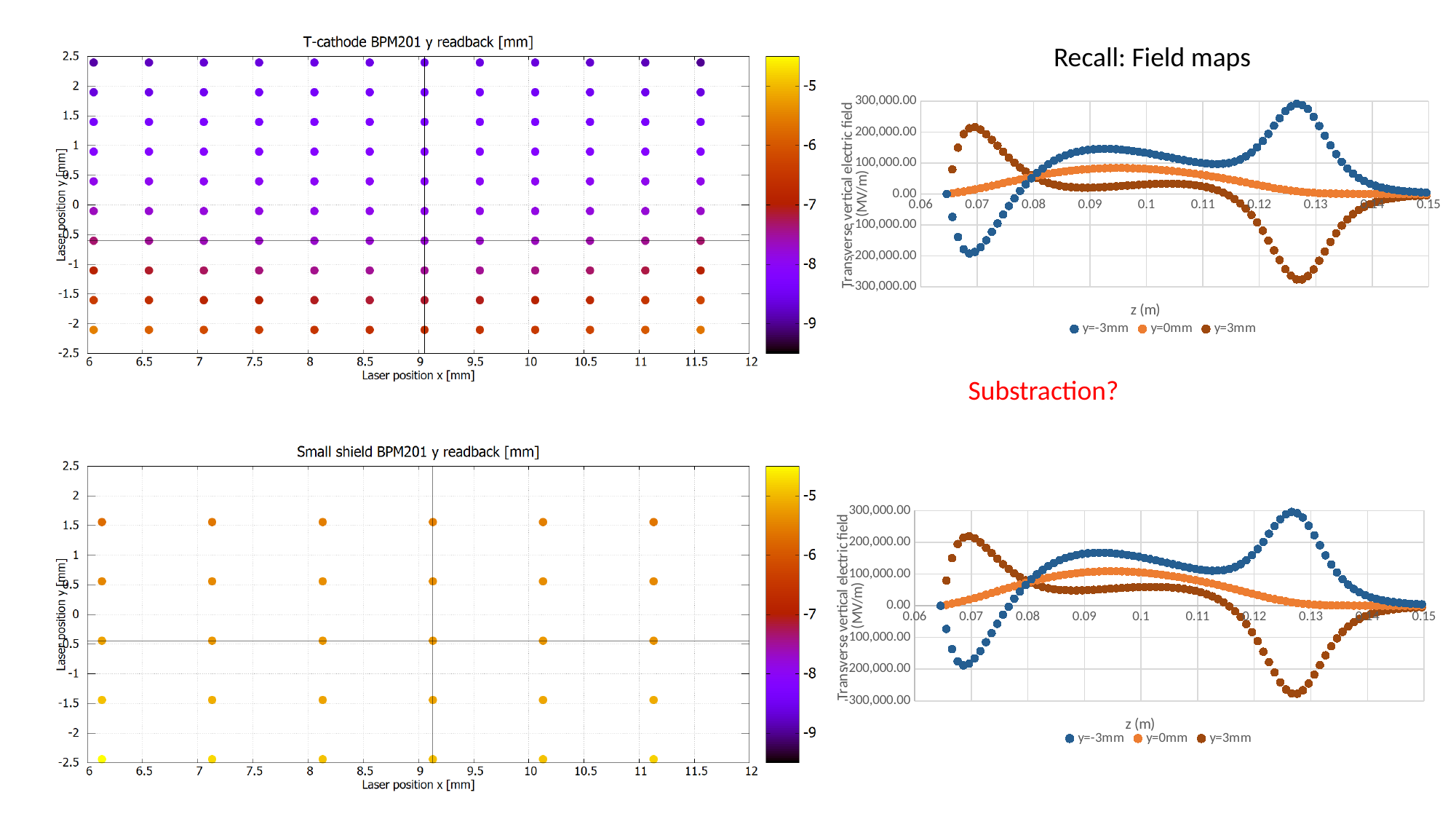
How many series does the legend of the top-right field map chart list? 3 What kind of chart is the top-right chart under 'Recall: Field maps'? Scatter chart How many columns of data points are plotted in the 'Small shield BPM201 y readback [mm]' chart? 6 In the 'T-cathode BPM201 y readback [mm]' chart, do the point colours move toward the yellow (higher) end of the colour scale as laser position y decreases? Yes How many rows of data points are plotted in the 'Small shield BPM201 y readback [mm]' chart? 5 In the bottom-right field map chart, which series has the larger value at z=0.1: y=0mm or y=3mm? y=0mm In the bottom-right field map chart, is the minimum value of the y=3mm series near z=0.127 greater or less than -200,000.00? less What is the x-axis title of the bottom-right field map chart? z (m) What are the legend entries of the bottom-right field map chart? y=-3mm, y=0mm, y=3mm In the top-right field map chart, which series reaches the lowest (most negative) value? y=3mm In the top-right field map chart, is the peak value of the y=-3mm series near z=0.127 greater or less than 200,000.00? greater In the top-right field map chart, which series reaches the highest positive value? y=-3mm